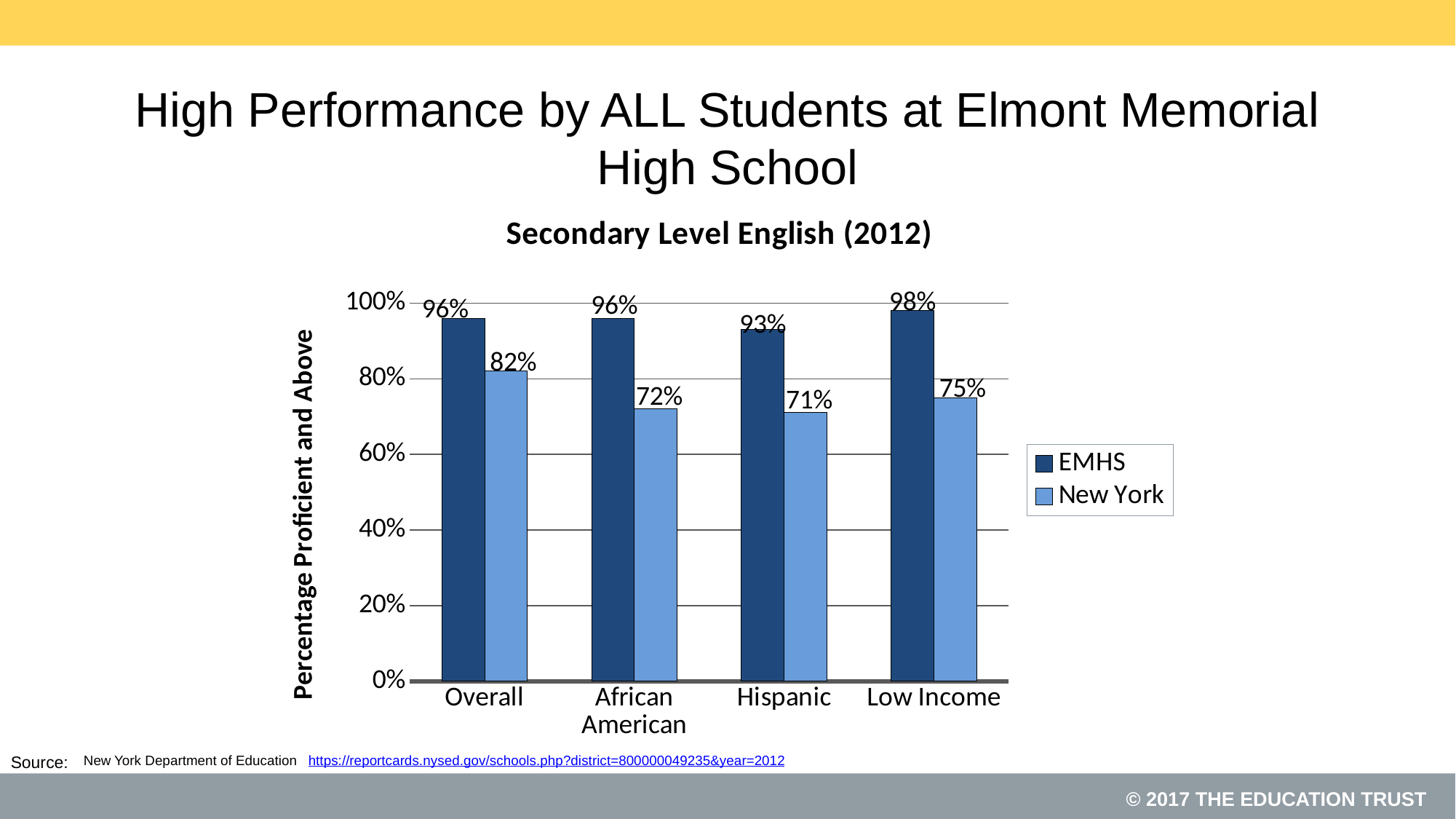
Which is larger for Overall: the EMHS value or the New York value? EMHS What is the New York value for Hispanic? 71% Is the New York value for Overall greater or less than 60%? greater What is the title of the chart? Secondary Level English (2012) What kind of chart is shown on the slide? Bar chart What is the EMHS value for Overall? 96% Which category has the lowest New York value? Hispanic Which category has the highest EMHS value? Low Income What is the New York value for Low Income? 75% How many series does the legend list? 2 How many categories are shown on the x axis? 4 What is the difference between the EMHS and New York values for African American? 24%